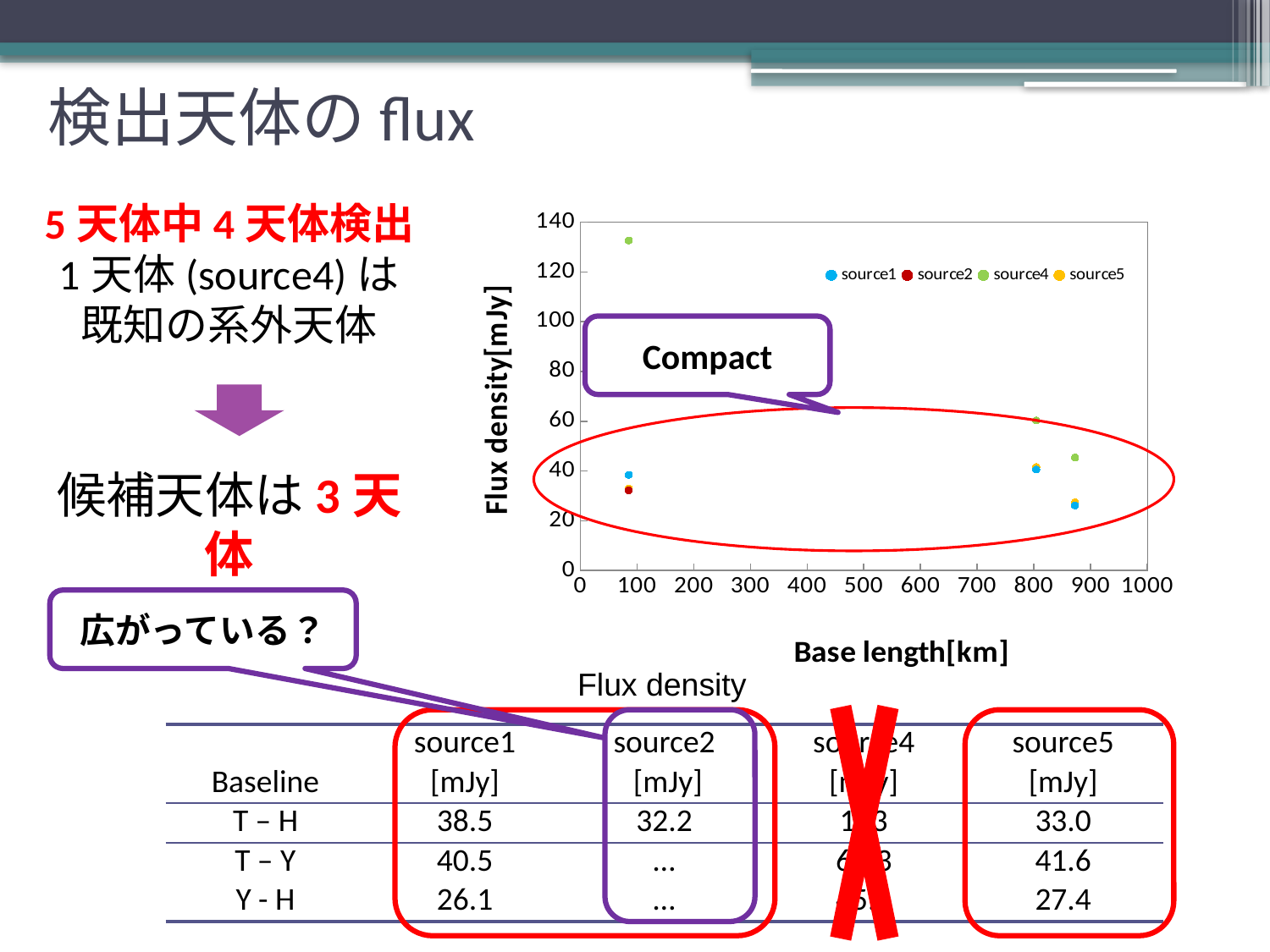
Is the source4 point near 800 km base length greater or less than 40 mJy? greater What is the title of the horizontal axis of the chart? Base length[km] At the shortest base length (near 100 km), which has the larger flux density: source4 or source2? source4 How many points are plotted for source2 in the chart? 1 Which series has the highest plotted flux density in the chart? source4 How many series does the chart legend list? 4 How many points are plotted for source4 in the chart? 3 Is the source2 point in the chart greater or less than 40 mJy? less What kind of chart is shown on the slide? scatter chart Is the source1 point near 900 km base length greater or less than 40 mJy? less What is the title of the vertical axis of the chart? Flux density[mJy]